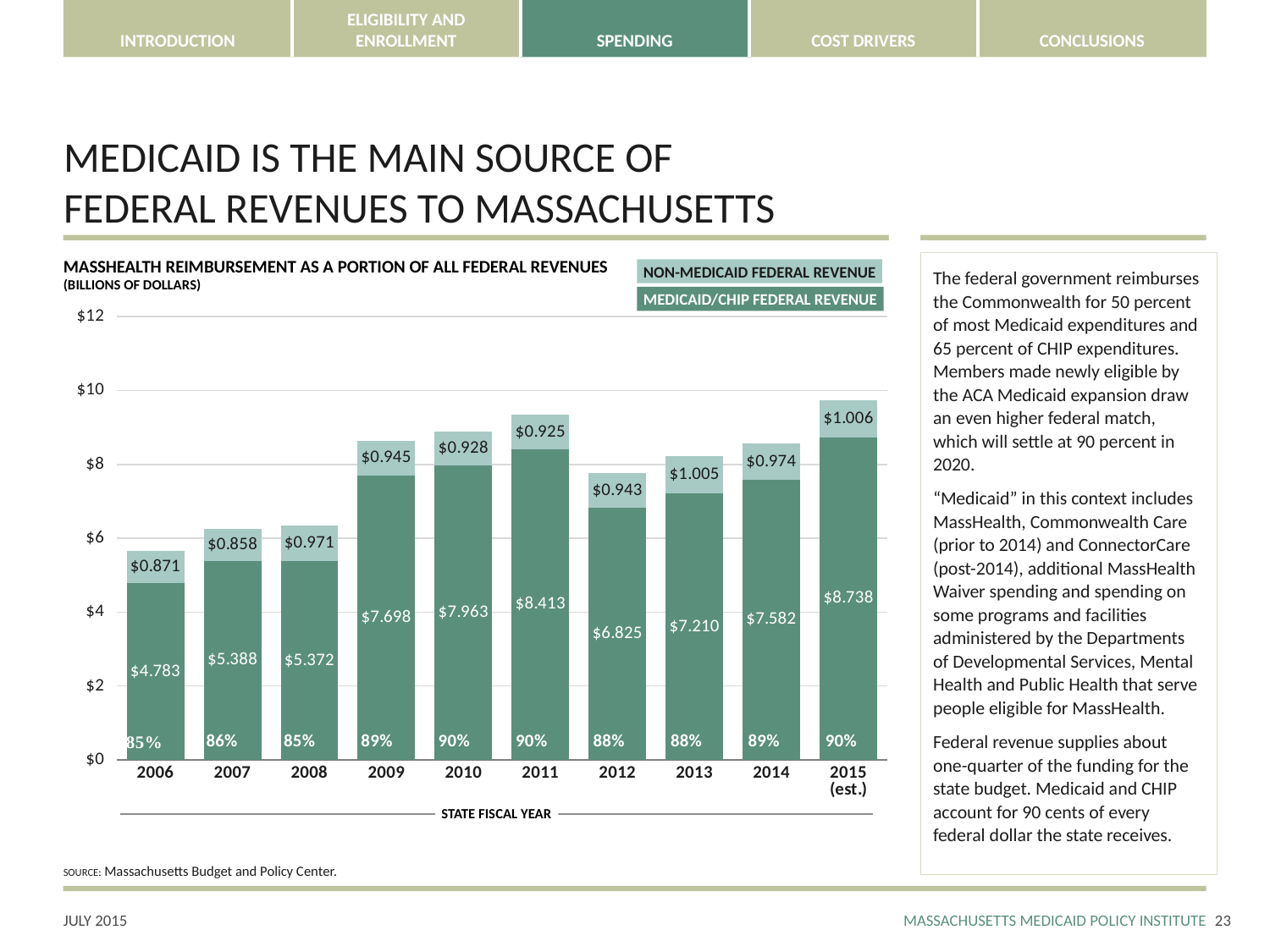
Is the total federal revenue bar for 2011 greater or less than $8? greater What is the total of the 2015 (est.) stacked bar (Medicaid/CHIP plus non-Medicaid federal revenue)? $9.744 Which state fiscal year has the lowest Medicaid/CHIP federal revenue? 2006 What percentage label is shown on the 2012 bar? 88% What is the non-Medicaid federal revenue for state fiscal year 2013? $1.005 What kind of chart is shown on the slide? Stacked bar chart What is the Medicaid/CHIP federal revenue for state fiscal year 2011? $8.413 How many state fiscal years are shown on the x axis? 10 Which year has the larger Medicaid/CHIP federal revenue, 2009 or 2012? 2009 Which state fiscal year has the highest Medicaid/CHIP federal revenue? 2015 (est.) By how much did Medicaid/CHIP federal revenue increase from 2014 to 2015 (est.)? $1.156 How many series does the legend list? 2